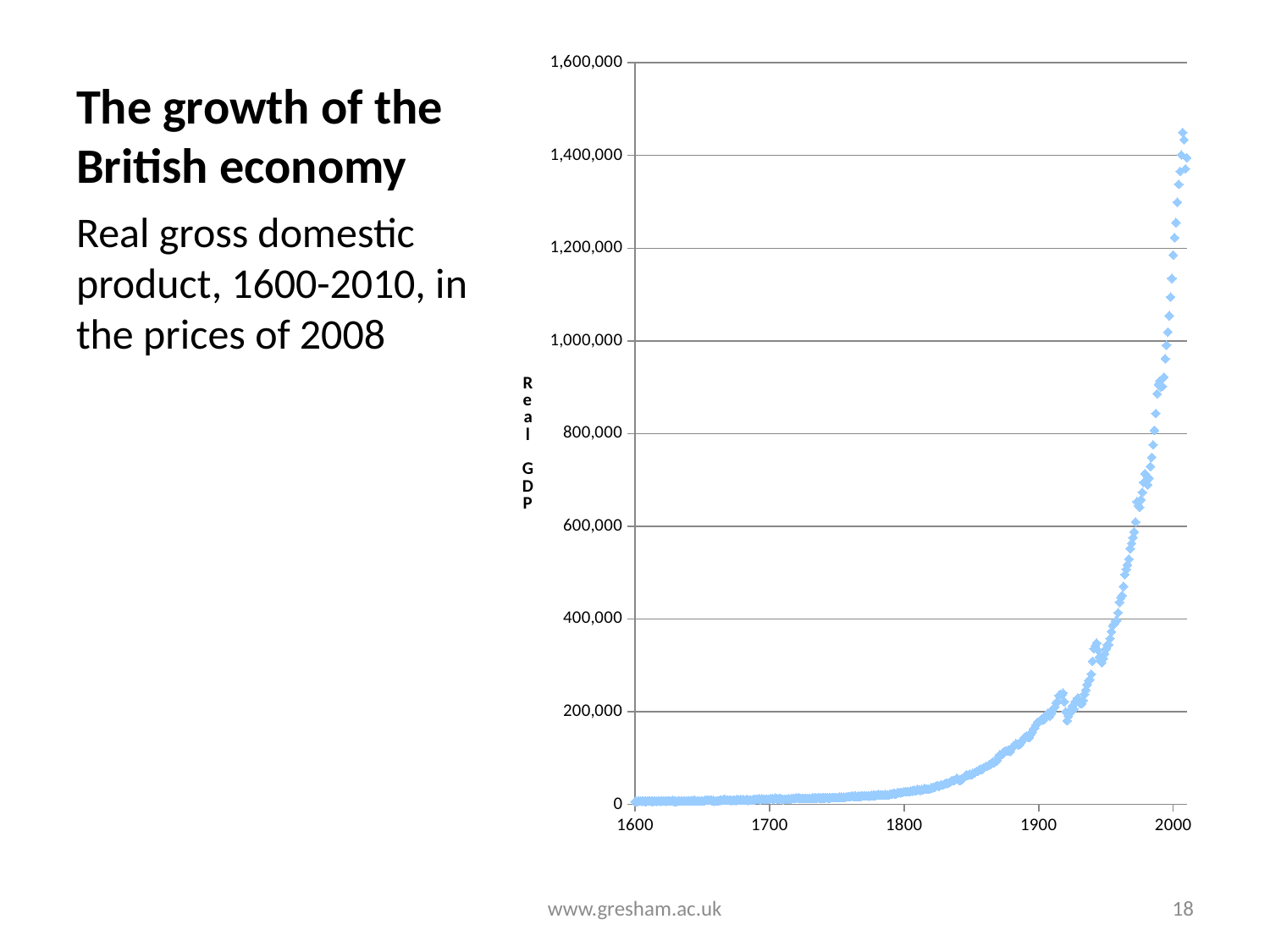
Is the Real GDP value around the year 1700 greater or less than 200,000? less Which is larger, the Real GDP value around 1900 or the value around 2000? 2000 Is the Real GDP value around the year 1950 greater or less than 600,000? less Is the highest Real GDP value plotted greater or less than 1,400,000? greater What is the label on the vertical axis of the chart? Real GDP What is the highest value shown on the vertical axis of the chart? 1,600,000 Do the Real GDP values generally rise or fall as the years go from 1600 to 2010? Rise What kind of chart is shown on the slide? Scatter chart